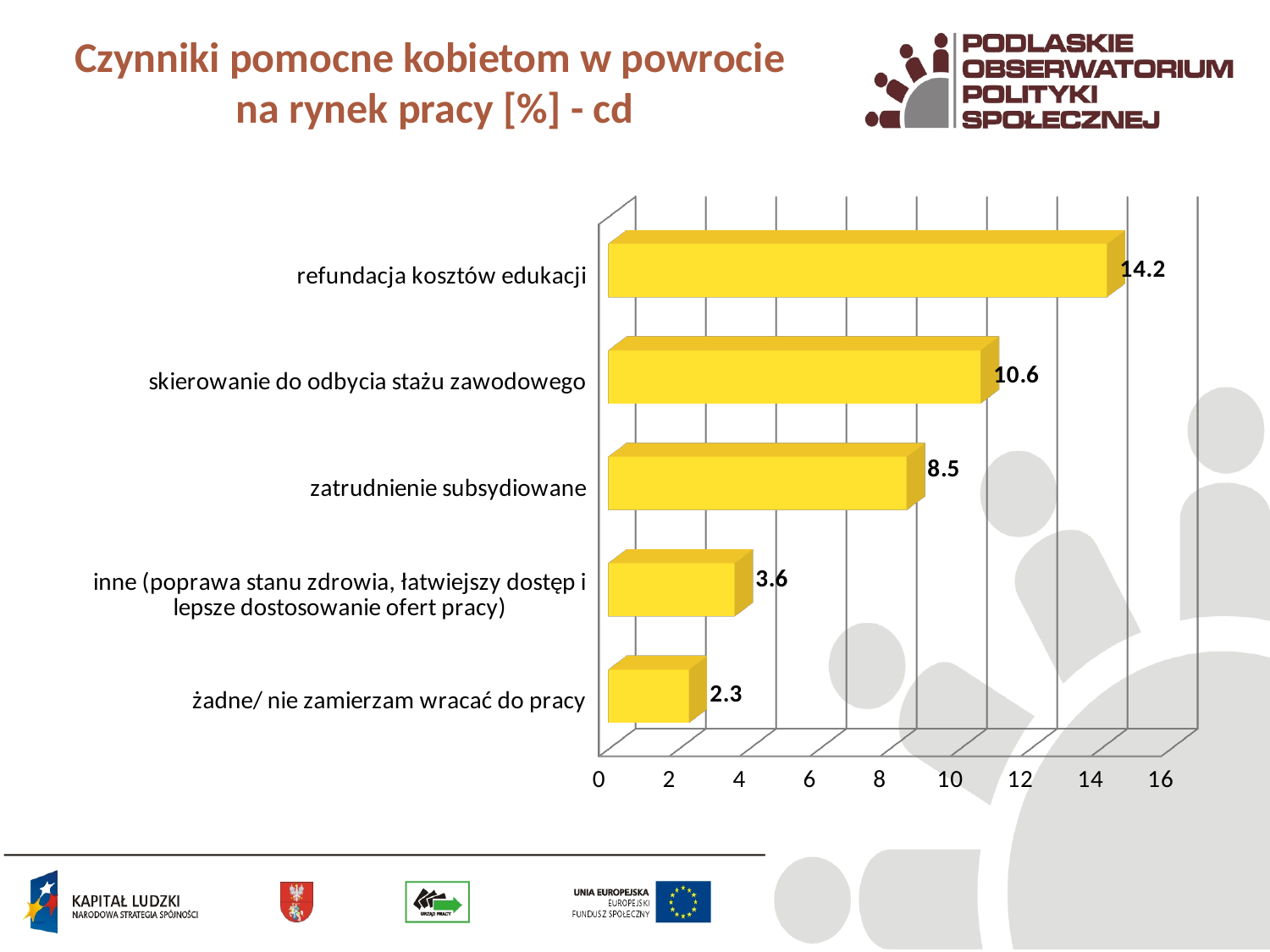
What is the difference between the values for "zatrudnienie subsydiowane" and "żadne/ nie zamierzam wracać do pracy"? 6.2 What is the title of the chart on the slide? Czynniki pomocne kobietom w powrocie na rynek pracy [%] - cd Which is larger: the value for "zatrudnienie subsydiowane" or the value for "inne (poprawa stanu zdrowia, łatwiejszy dostęp i lepsze dostosowanie ofert pracy)"? zatrudnienie subsydiowane Which category has the highest value? refundacja kosztów edukacji What is the value for "żadne/ nie zamierzam wracać do pracy"? 2.3 What kind of chart is shown on the slide? bar chart How many categories are shown in the chart? 5 What is the value for "zatrudnienie subsydiowane"? 8.5 What is the difference between the values for "refundacja kosztów edukacji" and "skierowanie do odbycia stażu zawodowego"? 3.6 Which category has the lowest value? żadne/ nie zamierzam wracać do pracy What is the value for "refundacja kosztów edukacji"? 14.2 What is the value for "skierowanie do odbycia stażu zawodowego"? 10.6